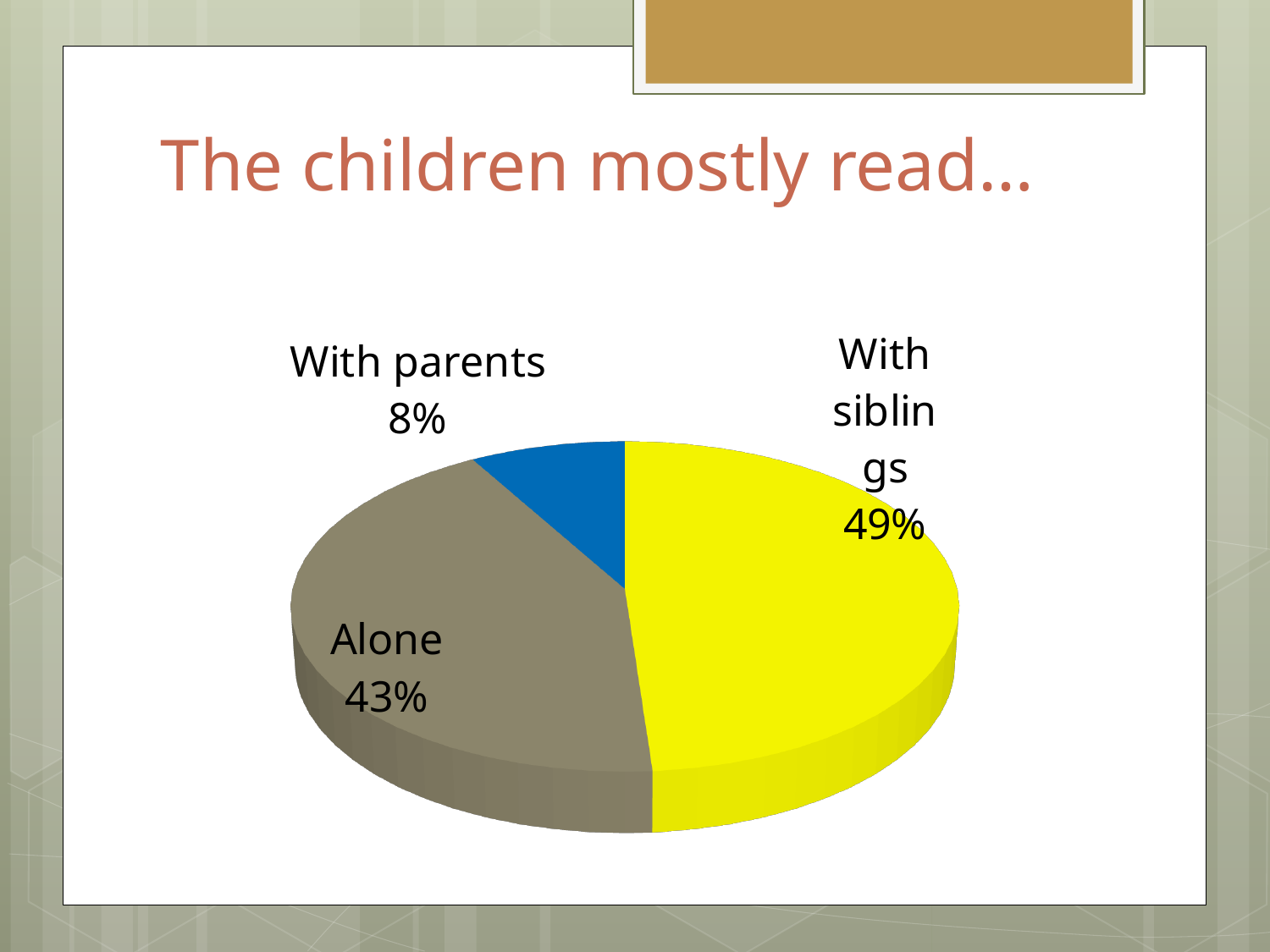
What is the difference in percentage points between 'Alone' and 'With parents'? 35 What colour is the 'With parents' slice? blue Which category has the smallest share of the pie? With parents Which category has the largest share of the pie? With siblings What is the difference in percentage points between 'With siblings' and 'Alone'? 6 Which is larger: the share for 'Alone' or the share for 'With parents'? Alone What percentage of children mostly read with siblings? 49% What percentage of children mostly read with parents? 8% What is the title of the slide containing the chart? The children mostly read… What kind of chart is shown on the slide? pie chart What percentage of children mostly read alone? 43% How many categories are shown in the pie chart? 3